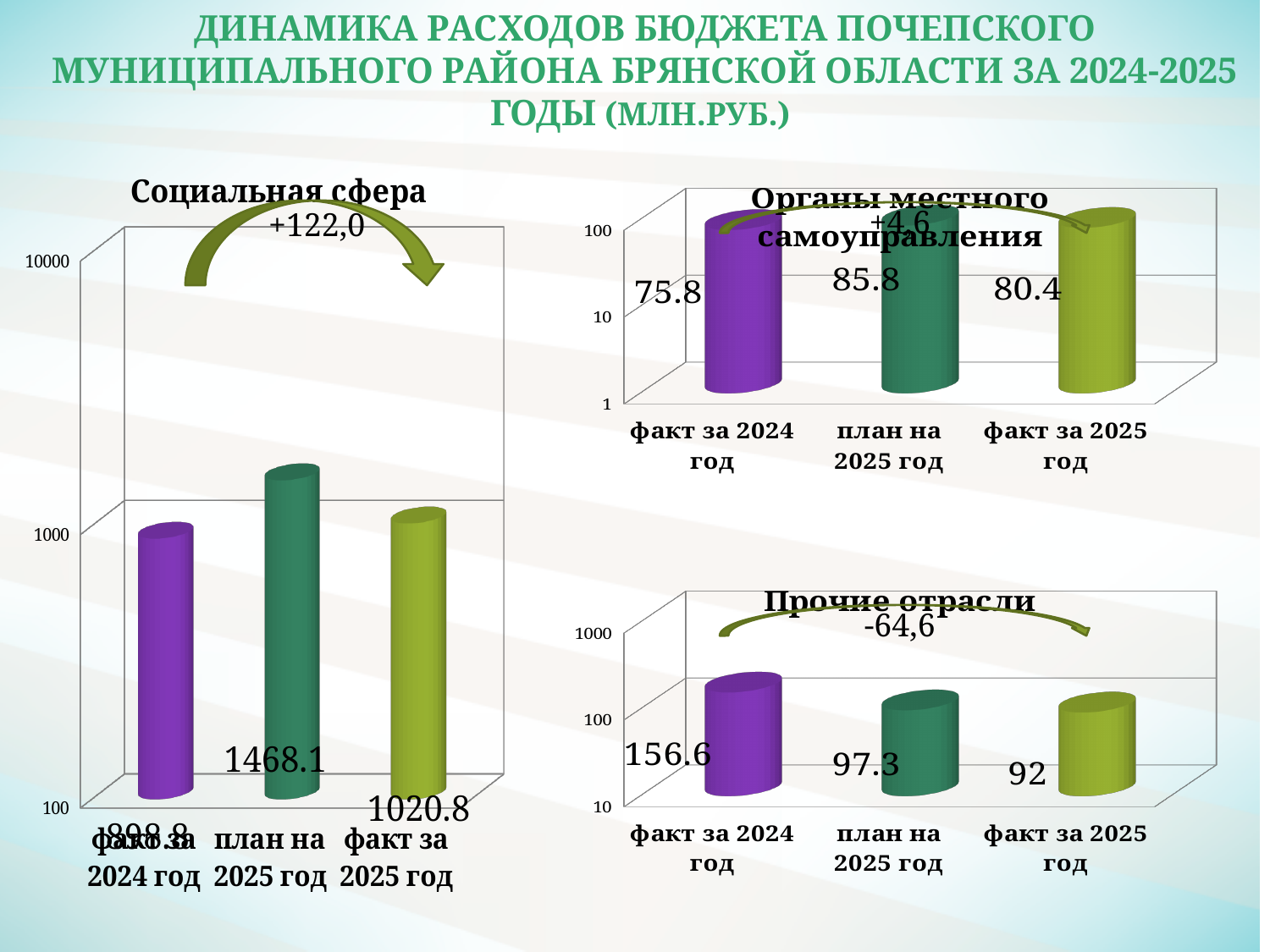
In the 'Органы местного самоуправления' chart, which category has the lowest value? факт за 2024 год In the 'Прочие отрасли' chart, how many categories are shown? 3 In the 'Органы местного самоуправления' chart, what is the value for 'план на 2025 год'? 85.8 In the 'Социальная сфера' chart, which category has the highest value? план на 2025 год In the 'Прочие отрасли' chart, what is the value for 'факт за 2024 год'? 156.6 What kind of chart is the 'Прочие отрасли' chart? bar chart In the 'Социальная сфера' chart, what is the value for 'факт за 2025 год'? 1020.8 In the 'Социальная сфера' chart, what is the difference between 'план на 2025 год' and 'факт за 2025 год'? 447.3 In the 'Прочие отрасли' chart, which is larger, 'план на 2025 год' or 'факт за 2025 год'? план на 2025 год In the 'Социальная сфера' chart, is the value for 'план на 2025 год' greater or less than 1000? greater In the 'Социальная сфера' chart, what is the value for 'план на 2025 год'? 1468.1 In the 'Органы местного самоуправления' chart, what is the difference between 'план на 2025 год' and 'факт за 2024 год'? 10